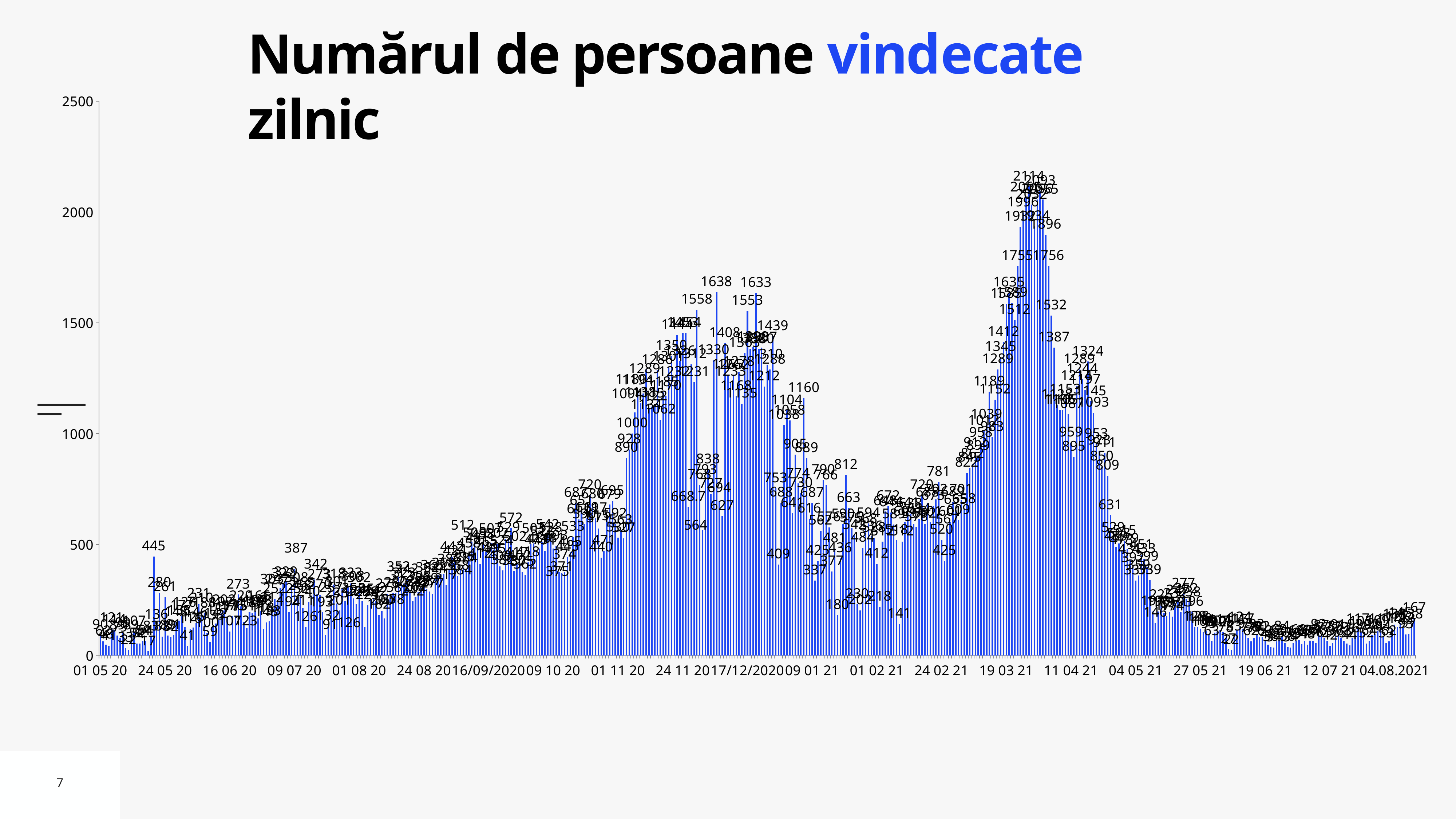
Is the value of the tall bar near 24 05 20 greater or less than 500? less What is the highest value labeled in the peak around 24 11 20 – 17/12/2020? 1638 Do the values generally rise or fall between 11 04 21 and 04 05 21? fall What is the highest value labeled on the chart? 2114 What is the maximum value shown on the vertical axis? 2500 What is the value of the tall isolated bar labeled near 24 05 20? 445 Which peak is higher: the one around 11 04 21 or the one around 24 11 20? the one around 11 04 21 Is the highest bar on the chart greater or less than 2000? greater What kind of chart is shown on the slide? bar chart What is the difference between the overall highest labeled value (2114) and the highest labeled value of the late-2020 peak (1638)? 476 What is the title of the chart? Numărul de persoane vindecate zilnic